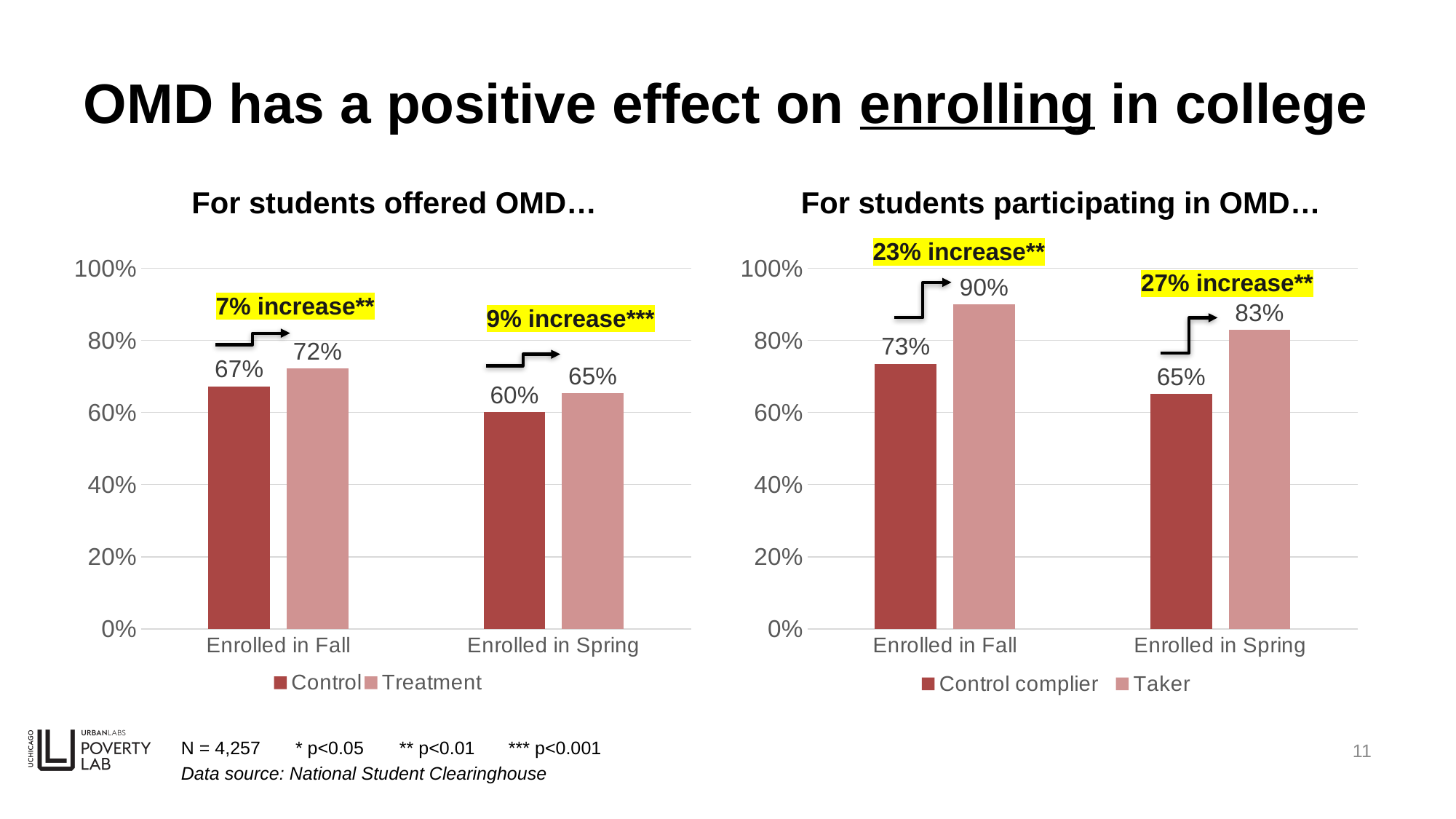
In the right chart (For students participating in OMD…), which bar is the highest? Taker, Enrolled in Fall In the left chart (For students offered OMD…), what is the difference between the Treatment and Control values for Enrolled in Fall? 5% In the right chart (For students participating in OMD…), what is the difference between the Taker and Control complier values for Enrolled in Spring? 18% In the right chart (For students participating in OMD…), which is larger for Enrolled in Fall: Control complier or Taker? Taker In the left chart (For students offered OMD…), what is the Treatment value for Enrolled in Spring? 65% How many series does the legend of the left chart (For students offered OMD…) list? 2 In the left chart (For students offered OMD…), which bar is the lowest? Control, Enrolled in Spring What kind of chart is the right chart (For students participating in OMD…)? Bar chart What are the two legend entries in the right chart (For students participating in OMD…)? Control complier and Taker In the right chart (For students participating in OMD…), what is the Taker value for Enrolled in Fall? 90% In the right chart (For students participating in OMD…), what is the Control complier value for Enrolled in Spring? 65% In the left chart (For students offered OMD…), what is the Control value for Enrolled in Fall? 67%